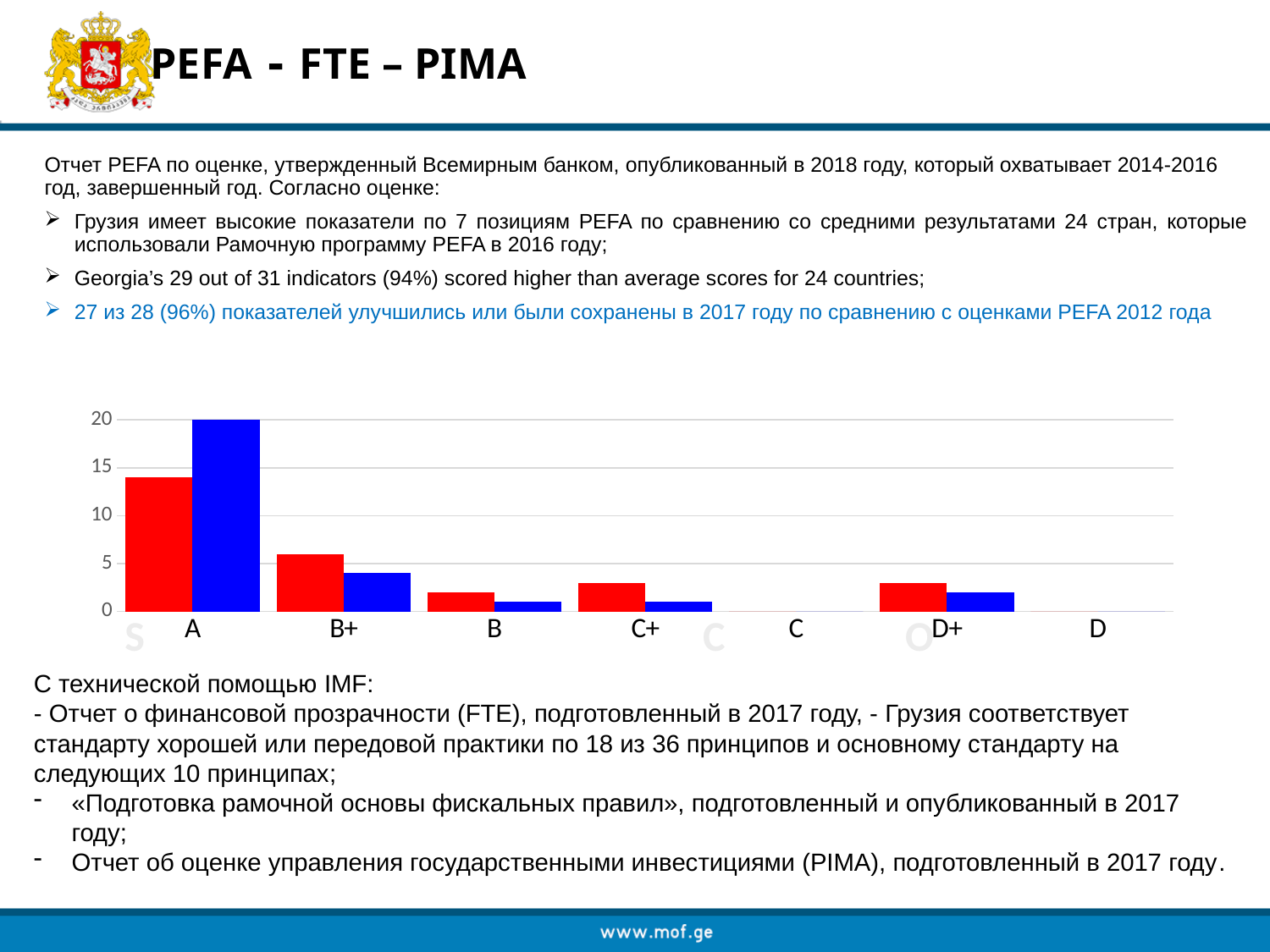
Is the blue bar for A greater or less than 15? greater Which category has the tallest bars in the chart? A What kind of chart is shown on the slide? bar chart Which is taller, the red bar for B or the red bar for C+? the red bar for C+ Is the red bar for B+ greater or less than 10? less What two colours are used for the bars in the chart? red and blue For category B+, which bar is taller, the red one or the blue one? the red one How many categories are shown on the x axis of the chart? 7 Do the bar heights generally rise or fall moving from A to D along the x axis? fall Is the red bar for A greater or less than 10? greater For category A, which bar is taller, the red one or the blue one? the blue one